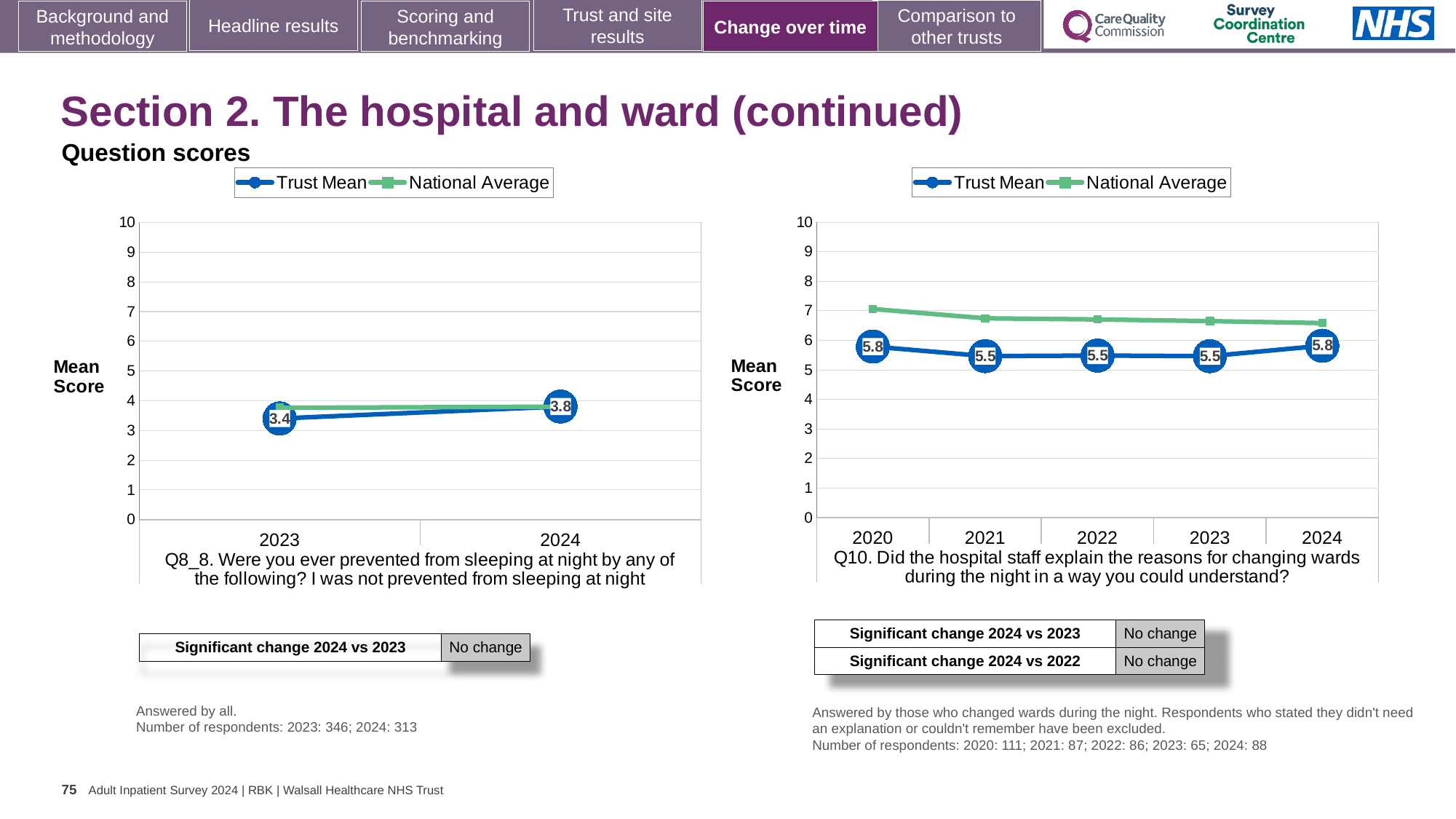
In the left chart (Q8_8), by how much did the Trust Mean score change from 2023 to 2024? 0.4 In the right chart (Q10), what is the Trust Mean score for 2020? 5.8 How many series does the legend of the left chart list? 2 In the right chart (Q10), what is the Trust Mean score for 2022? 5.5 In the right chart (Q10), how many years are plotted on the x axis? 5 In the left chart (Q8_8), does the Trust Mean rise or fall from 2023 to 2024? rise In the left chart (Q8_8), is the National Average for 2023 greater or less than 3? greater In the left chart (Q8_8), what is the Trust Mean score for 2023? 3.4 In the left chart (Q8_8), what is the Trust Mean score for 2024? 3.8 In the right chart (Q10), which series has the higher value in 2024, Trust Mean or National Average? National Average In the right chart (Q10), what is the difference between the Trust Mean scores for 2024 and 2023? 0.3